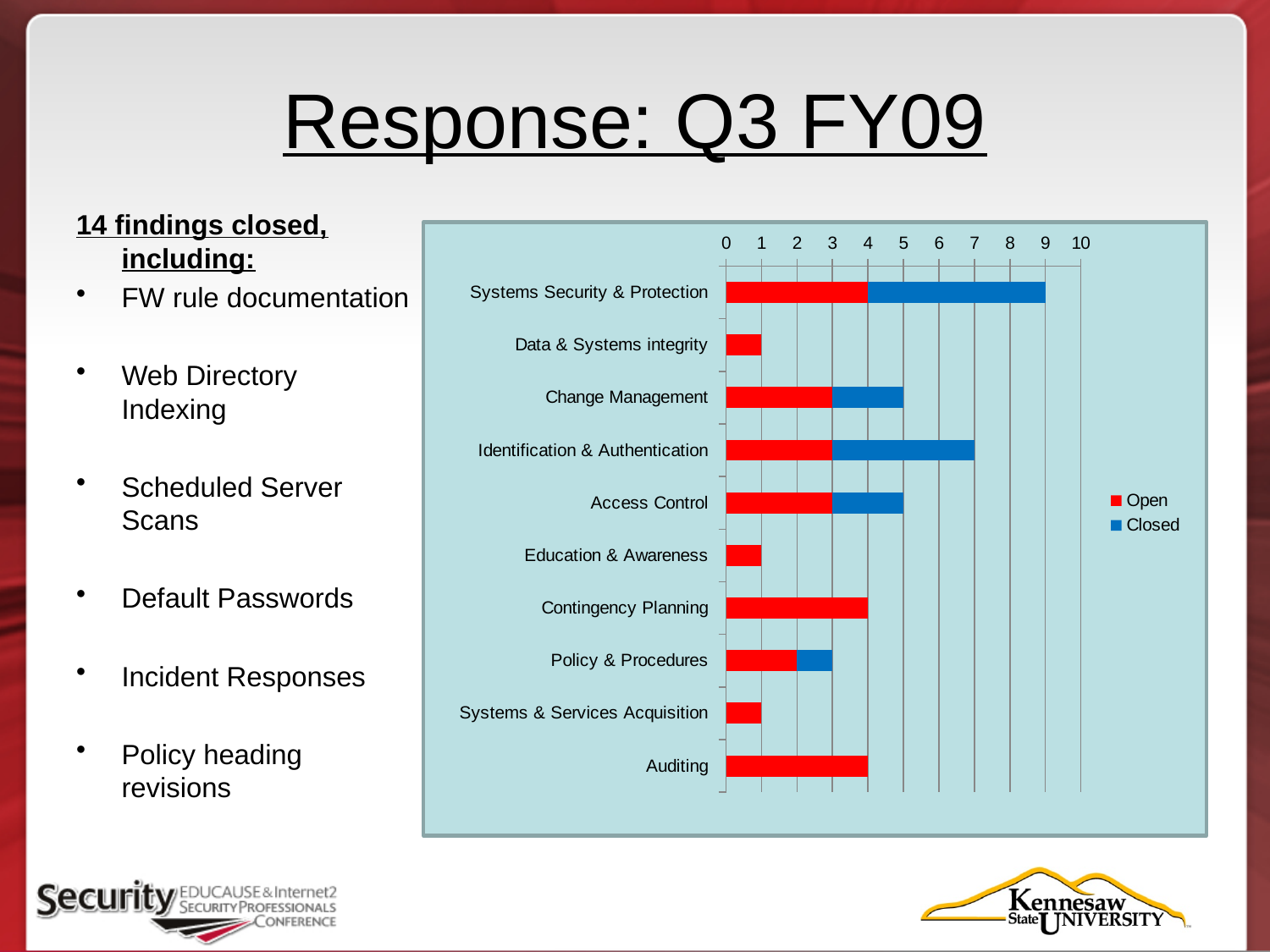
Which has a longer total bar, Auditing or Policy & Procedures? Auditing Which colour represents the Closed series in the legend? Blue How many categories are plotted on the chart? 10 What is the total length of the stacked bar for Identification & Authentication? 7 Which category has the longest total bar on the chart? Systems Security & Protection What is the Open value for Contingency Planning? 4 Which category has a larger Closed value, Identification & Authentication or Access Control? Identification & Authentication How many series does the chart legend list? 2 What kind of chart is shown on the slide? Stacked bar chart What is the Open value for Systems Security & Protection? 4 What is the total length of the stacked bar for Systems Security & Protection? 9 Is the total bar for Change Management greater or less than 4? greater